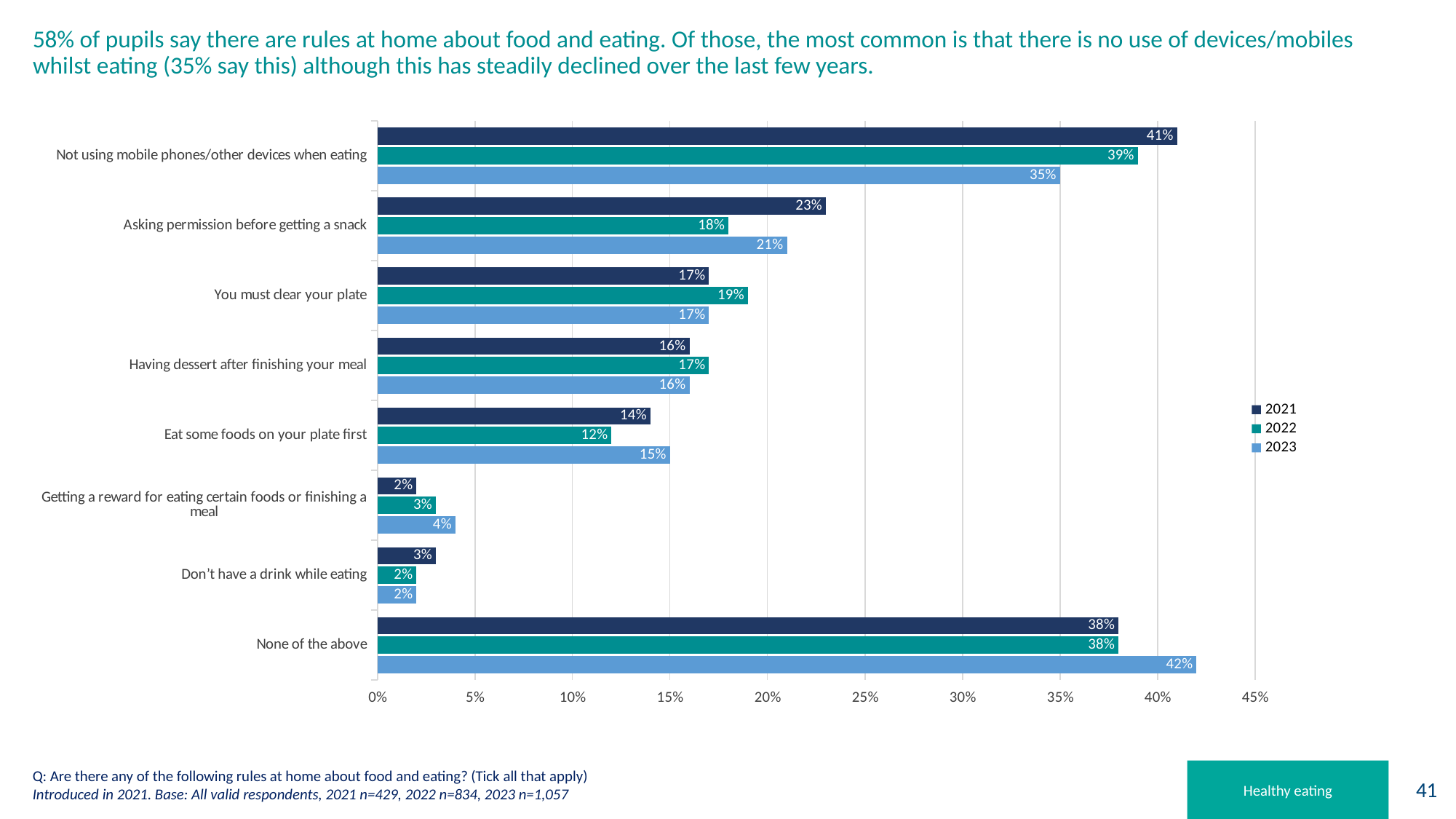
What kind of chart is shown on the slide? Bar chart What is the 2023 value for 'Not using mobile phones/other devices when eating'? 35% How many categories are shown on the chart? 8 Does the value for 'Not using mobile phones/other devices when eating' rise or fall from 2021 to 2023? Fall What is the difference between the 2021 and 2023 values for 'Not using mobile phones/other devices when eating'? 6% Which category has the highest 2021 value? Not using mobile phones/other devices when eating What is the 2023 value for 'None of the above'? 42% Which is larger for 'Eat some foods on your plate first': the 2022 value or the 2023 value? 2023 What is the 2022 value for 'You must clear your plate'? 19% What is the 2021 value for 'Asking permission before getting a snack'? 23% How many series does the legend list? 3 Which category has the lowest 2023 value? Don't have a drink while eating